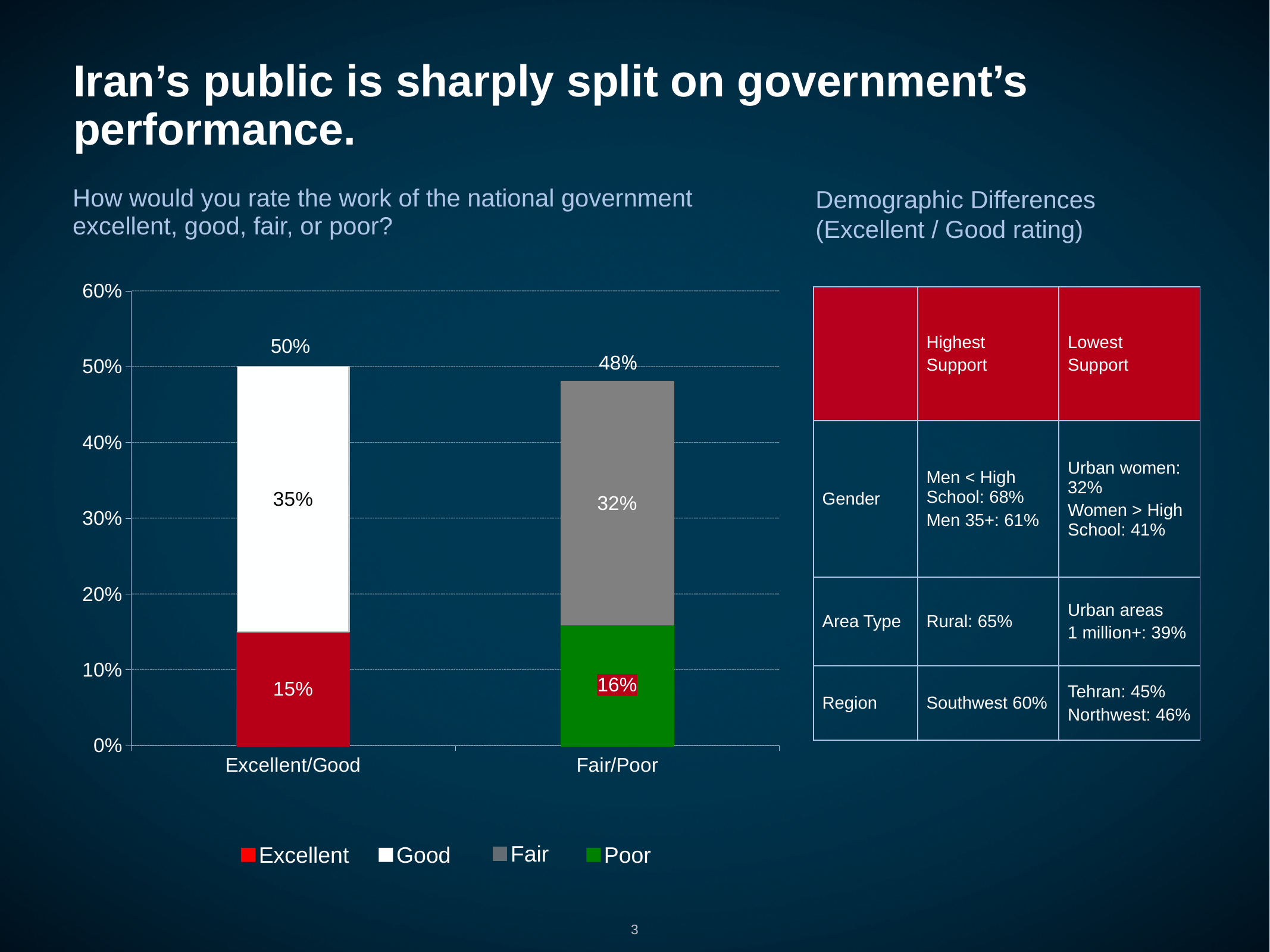
What kind of chart is shown on the slide? Stacked bar chart What is the value for Good in the Excellent/Good bar? 35% What is the value for Fair in the Fair/Poor bar? 32% Which is larger, the Fair value or the Poor value? Fair How many series does the legend list? 4 What is the total of the Excellent/Good stacked bar? 50% What is the total of the Fair/Poor stacked bar? 48% What is the difference between the Good value and the Excellent value? 20% What is the value for Excellent in the Excellent/Good bar? 15% How many categories are shown on the x axis? 2 Which series has the highest value in the chart? Good What is the value for Poor in the Fair/Poor bar? 16%